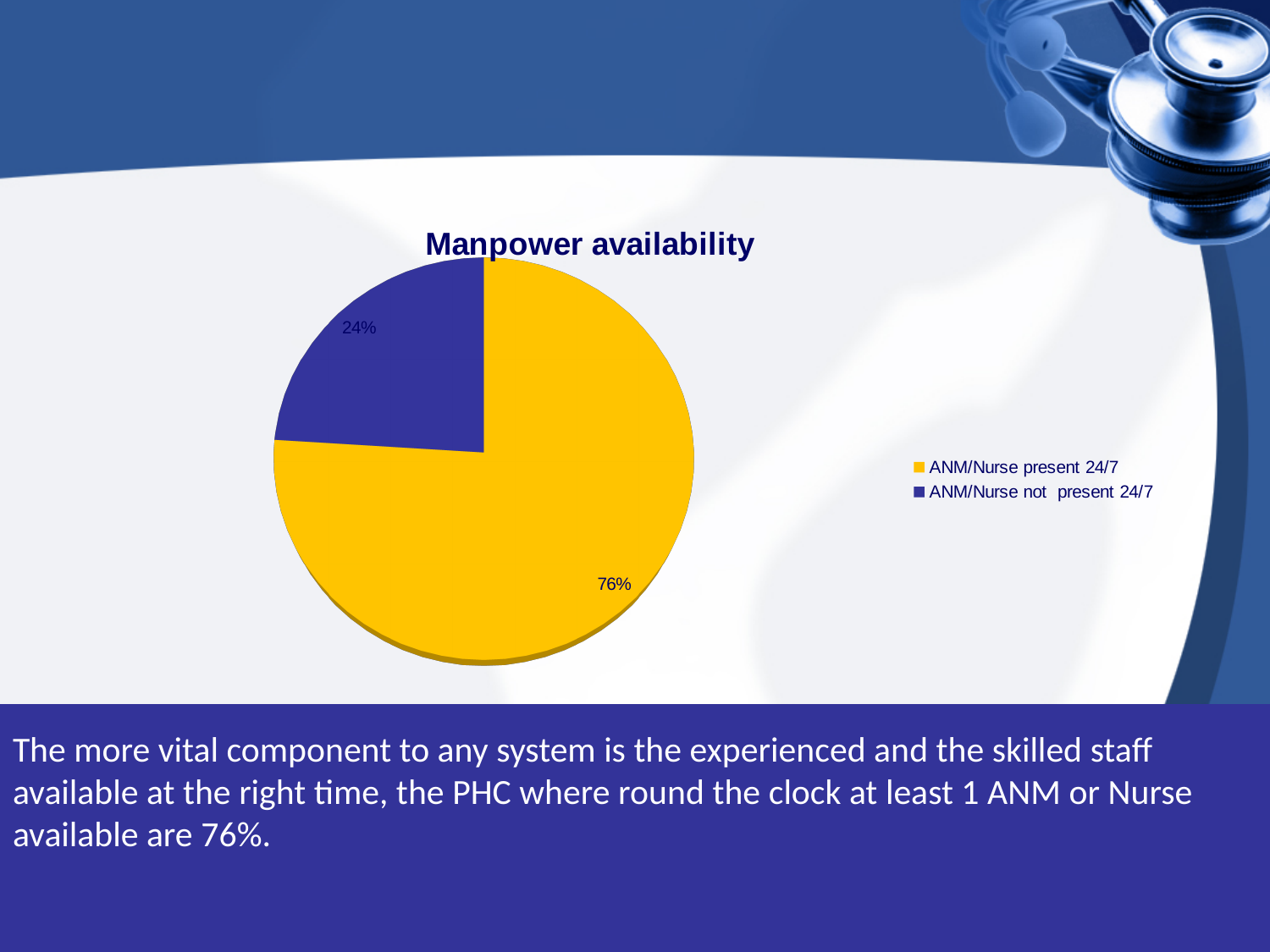
Which slice of the pie is the largest? ANM/Nurse present 24/7 What is the difference in percentage points between the "ANM/Nurse present 24/7" slice and the "ANM/Nurse not present 24/7" slice? 52 What share of the pie is labelled "ANM/Nurse present 24/7"? 76% What share of the pie is labelled "ANM/Nurse not present 24/7"? 24% Which slice of the pie is the smallest? ANM/Nurse not present 24/7 What colour is the "ANM/Nurse present 24/7" slice? yellow How many entries does the legend list? 2 Which is larger: the "ANM/Nurse present 24/7" slice or the "ANM/Nurse not present 24/7" slice? ANM/Nurse present 24/7 How many slices does the pie chart have? 2 What kind of chart is shown on the slide? pie chart What is the title of the chart? Manpower availability